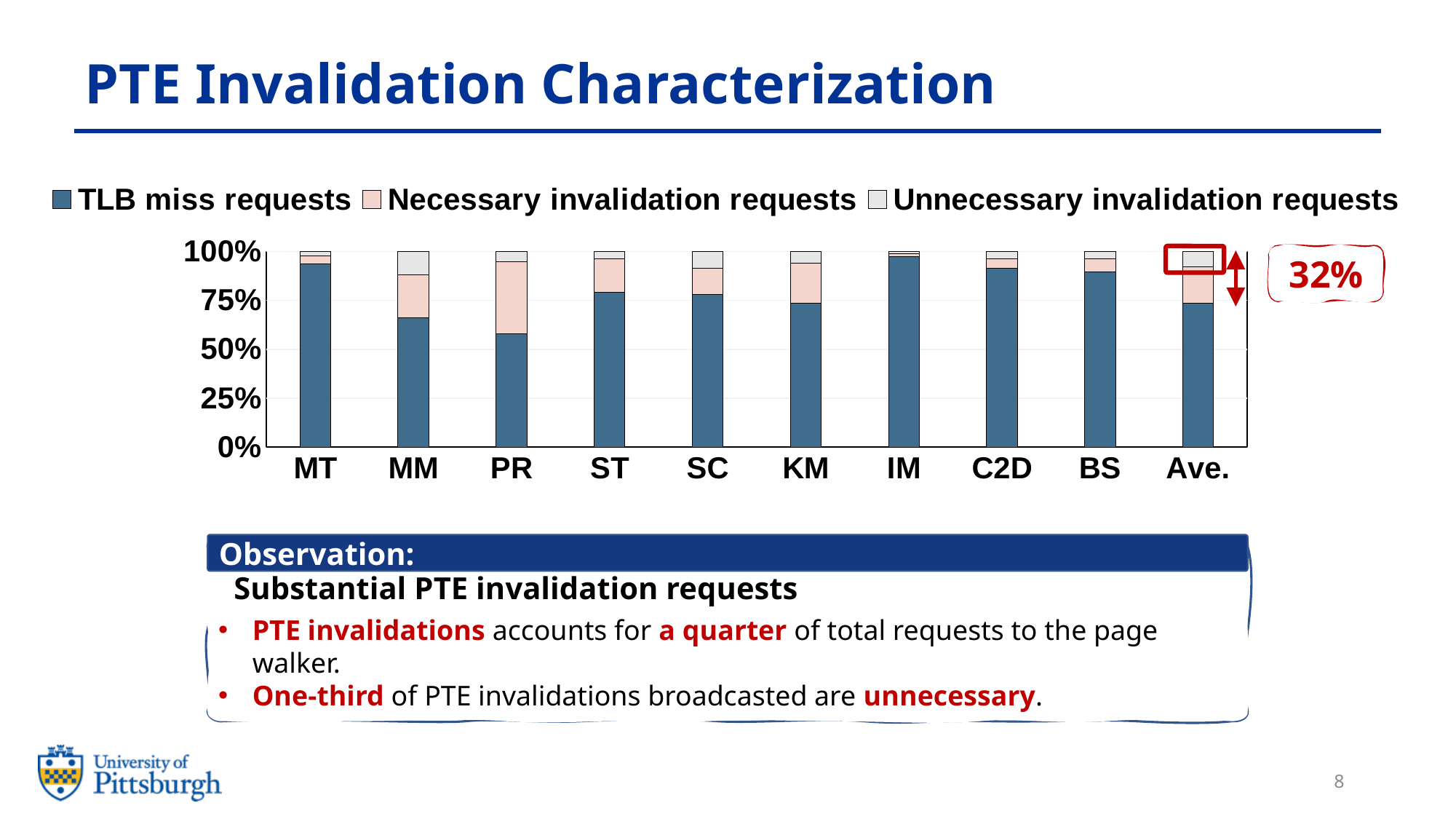
What value is written in the red annotation next to the Ave. bar? 32% Is the TLB miss requests share for PR greater or less than 50%? greater What is the total of the stacked bar for MT? 100% How many series does the chart's legend list? 3 How many categories are shown along the x axis of the chart? 10 Which has a larger share of Necessary invalidation requests, PR or IM? PR Is the TLB miss requests share for MT greater or less than 75%? greater Which category has the lowest share of TLB miss requests? PR Is the TLB miss requests share for MM greater or less than 75%? less Which has a larger share of TLB miss requests, MM or PR? MM What kind of chart is shown on the slide? bar chart Which category has the highest share of TLB miss requests? IM